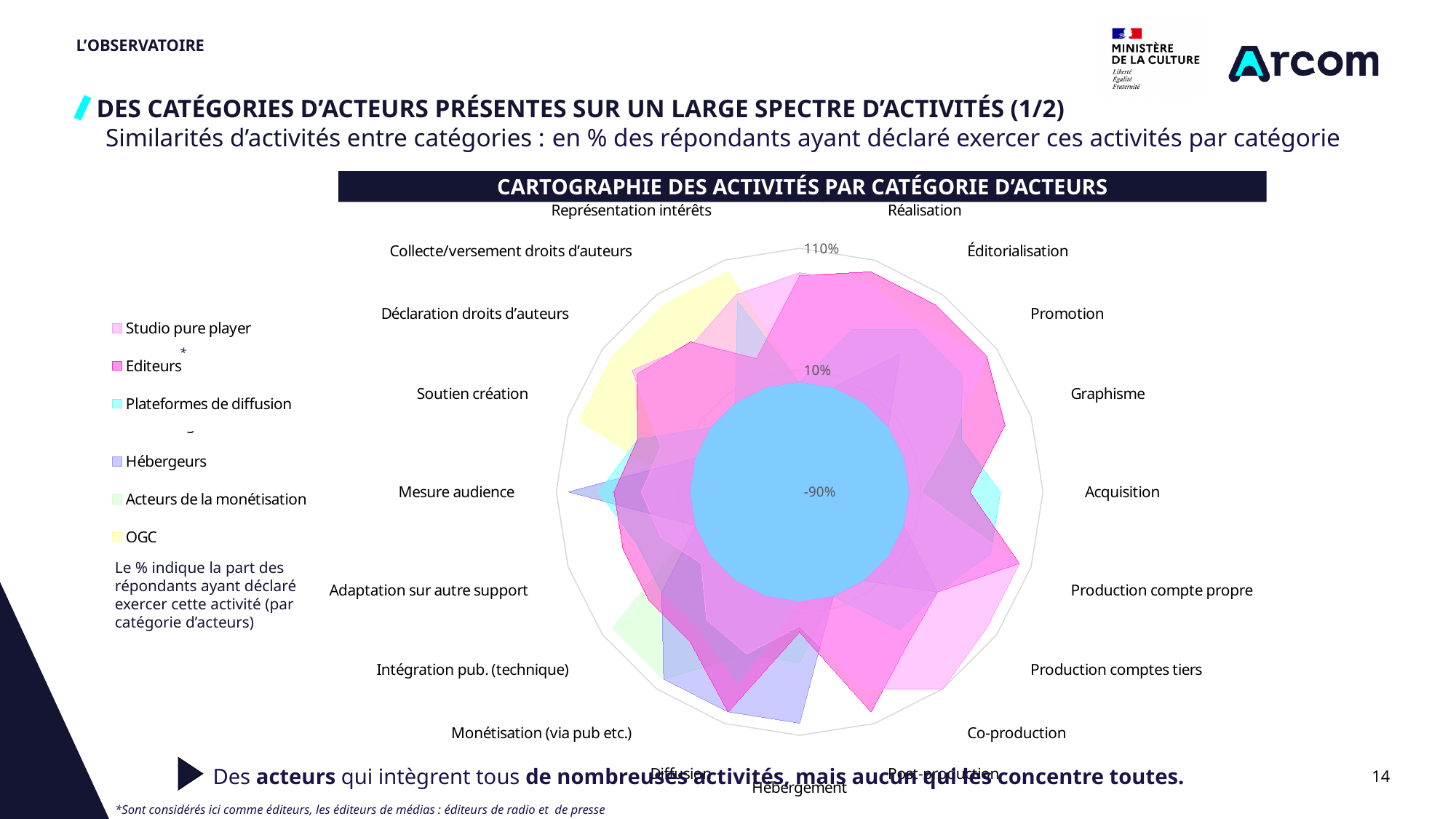
How many activity categories are plotted around the radar chart? 20 What is the title of the chart? CARTOGRAPHIE DES ACTIVITÉS PAR CATÉGORIE D'ACTEURS Which series extends furthest out at the 'Mesure audience' axis? Plateformes de diffusion Which series extends furthest out at the 'Collecte/versement droits d'auteurs' axis? OGC What kind of chart is shown on the slide? Radar chart Which series extends furthest out at the 'Hébergement' axis? Hébergeurs Which series is shown in yellow in the legend? OGC How many series does the legend list? 6